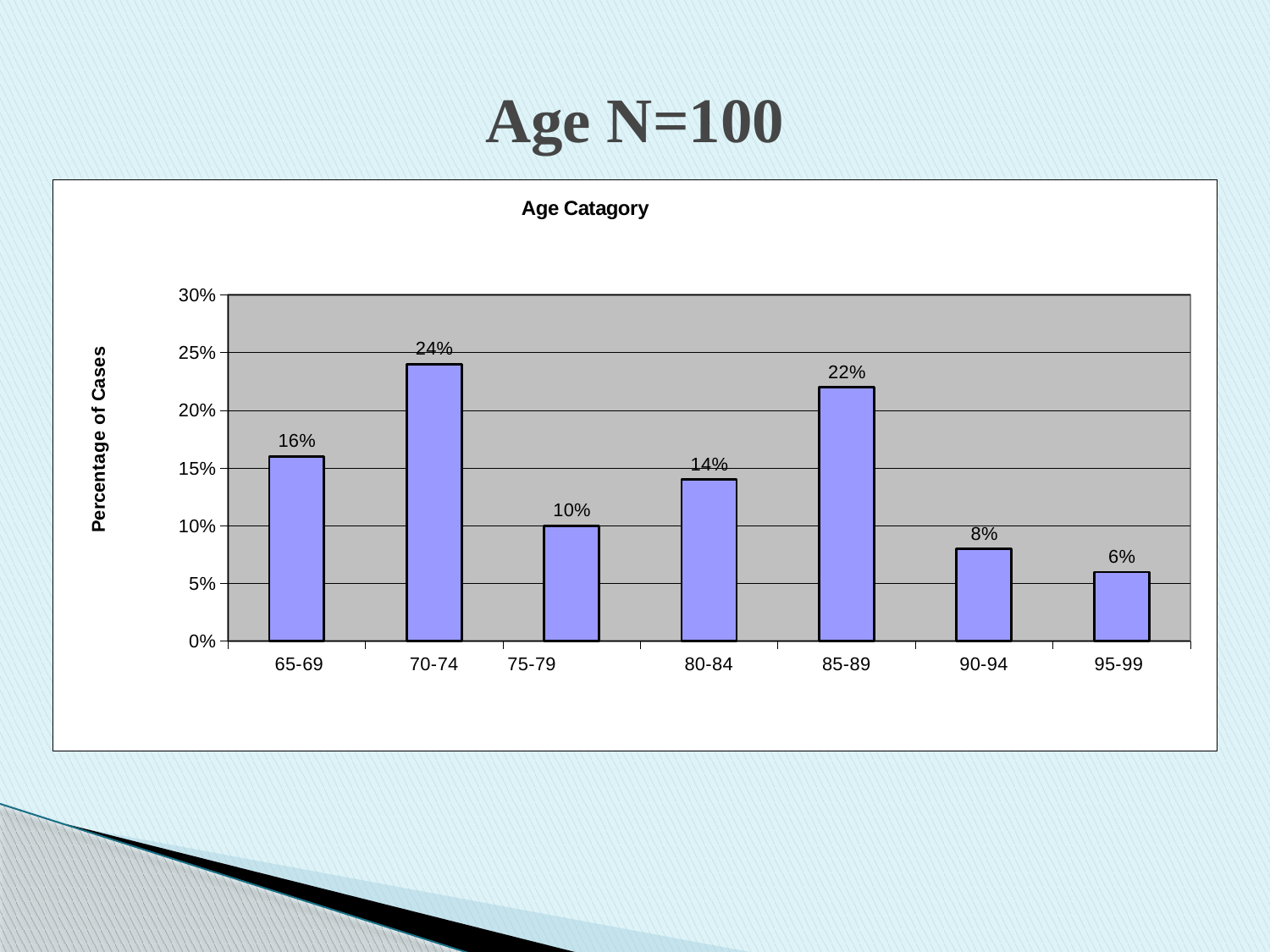
What is the title of the chart? Age Catagory What kind of chart is shown on the slide? Bar chart What is the percentage of cases for the 95-99 age category? 6% Which age category has a larger percentage of cases, 65-69 or 75-79? 65-69 What is the percentage of cases for the 80-84 age category? 14% Which age category has the lowest percentage of cases? 95-99 What is the percentage of cases for the 70-74 age category? 24% How many age categories are shown on the chart? 7 What is the difference in percentage of cases between the 65-69 and 90-94 age categories? 8% Which age category has the highest percentage of cases? 70-74 What is the difference in percentage of cases between the 70-74 and 85-89 age categories? 2% Is the value for the 85-89 age category greater or less than 20%? greater